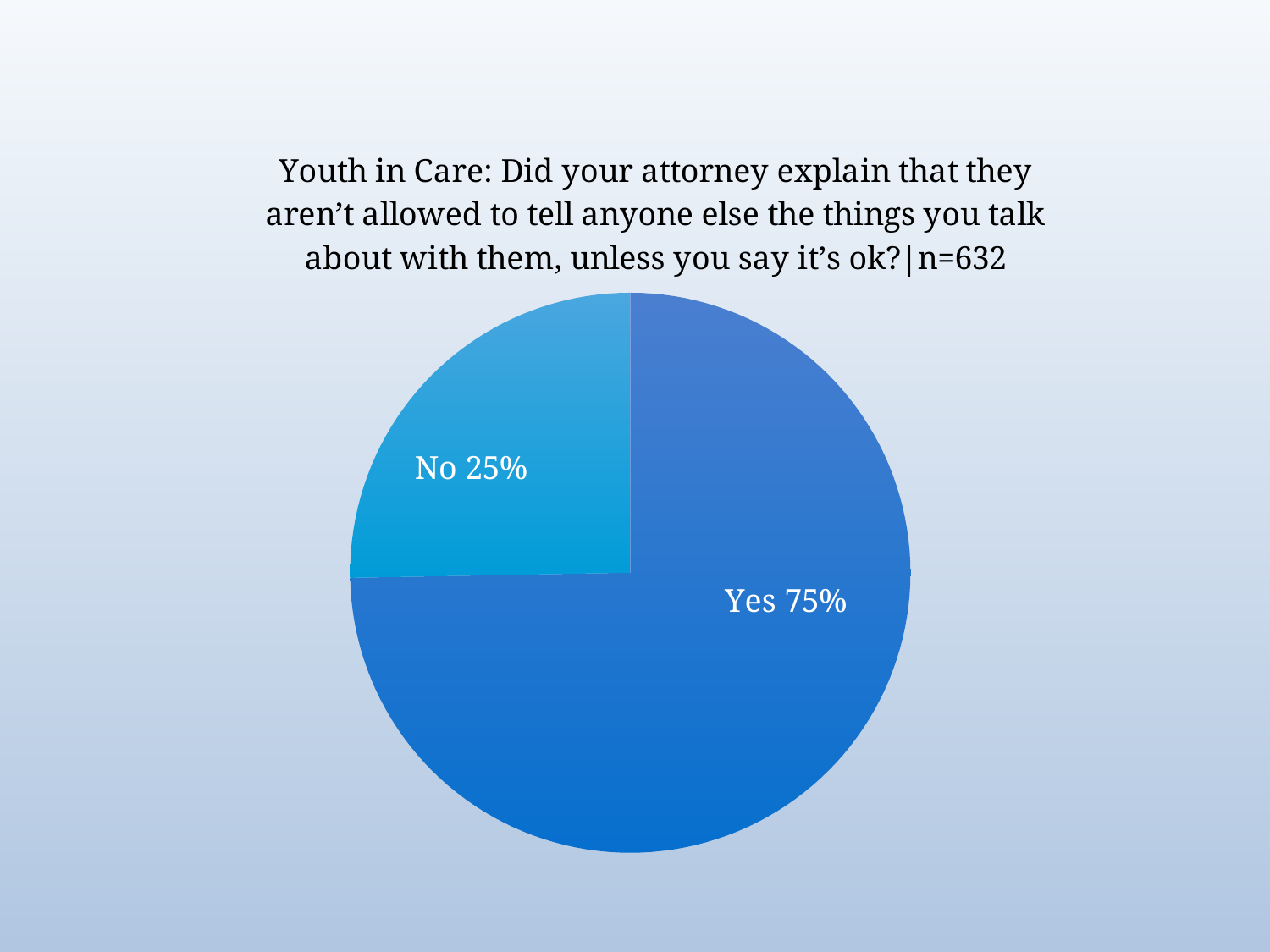
Which group of respondents is the chart about, according to the title? Youth in Care Which response is larger, Yes or No? Yes What is the sample size (n) stated in the chart title? 632 What kind of chart is shown on the slide? Pie chart What percentage of youth in care answered Yes? 75% Which response has the largest share of the pie? Yes How many slices does the pie chart have? 2 What is the difference in percentage points between the Yes and No responses? 50 What share of the pie does the No slice represent? 25% Which response has the smallest share of the pie? No What percentage of youth in care answered No? 25%